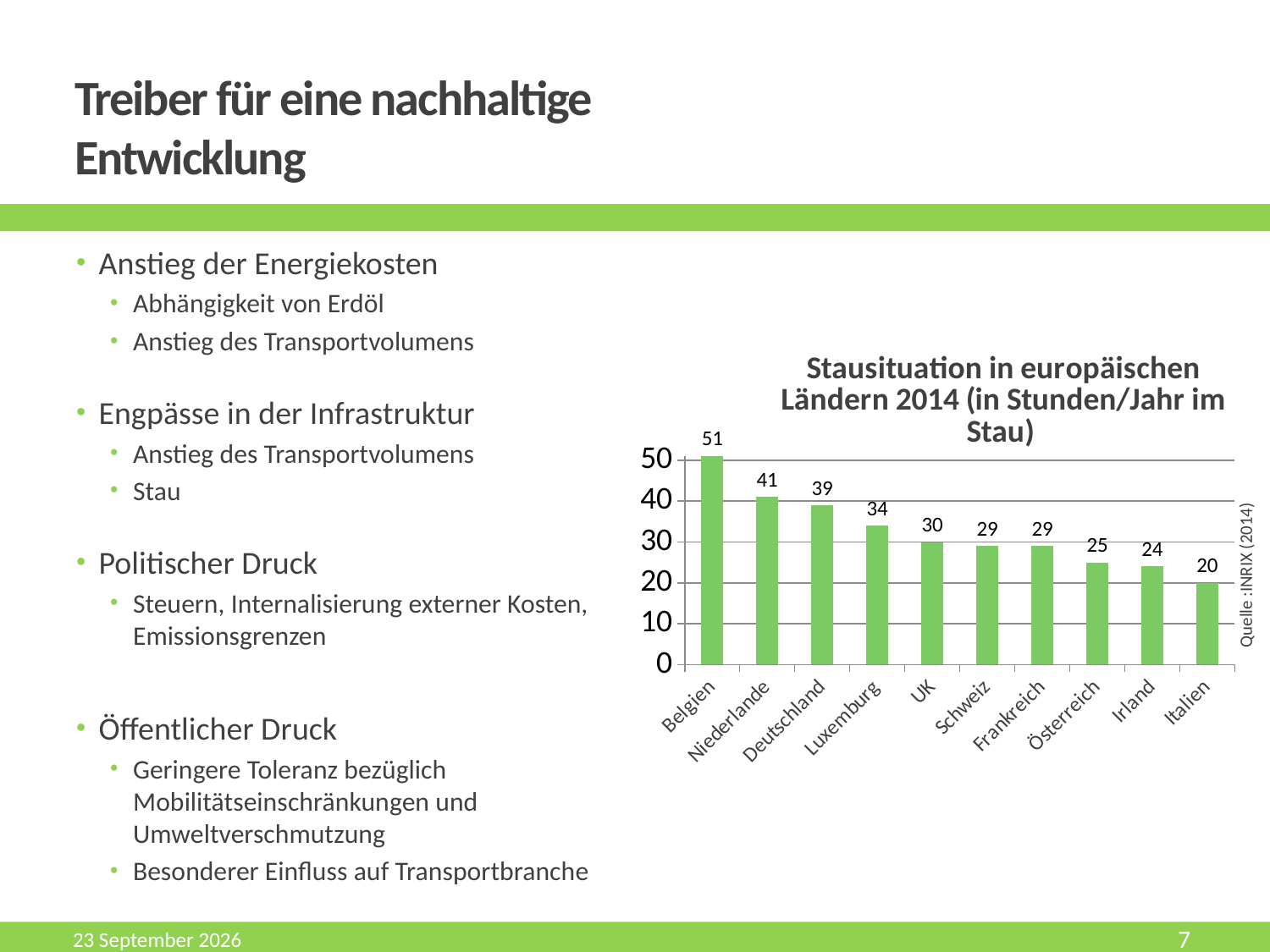
What is the value for Luxemburg in the chart? 34 Which has a larger value, Luxemburg or UK? Luxemburg How many countries are shown in the chart? 10 What is the value for Belgien in the chart? 51 What is the title of the chart? Stausituation in europäischen Ländern 2014 (in Stunden/Jahr im Stau) Is the value for Österreich greater or less than 30? less What is the difference between the values for Belgien and Niederlande? 10 What kind of chart is shown on the slide? bar chart Which country has the highest value in the chart? Belgien What is the value for Deutschland in the chart? 39 What is the difference between the values for Irland and Italien? 4 Which country has the lowest value in the chart? Italien